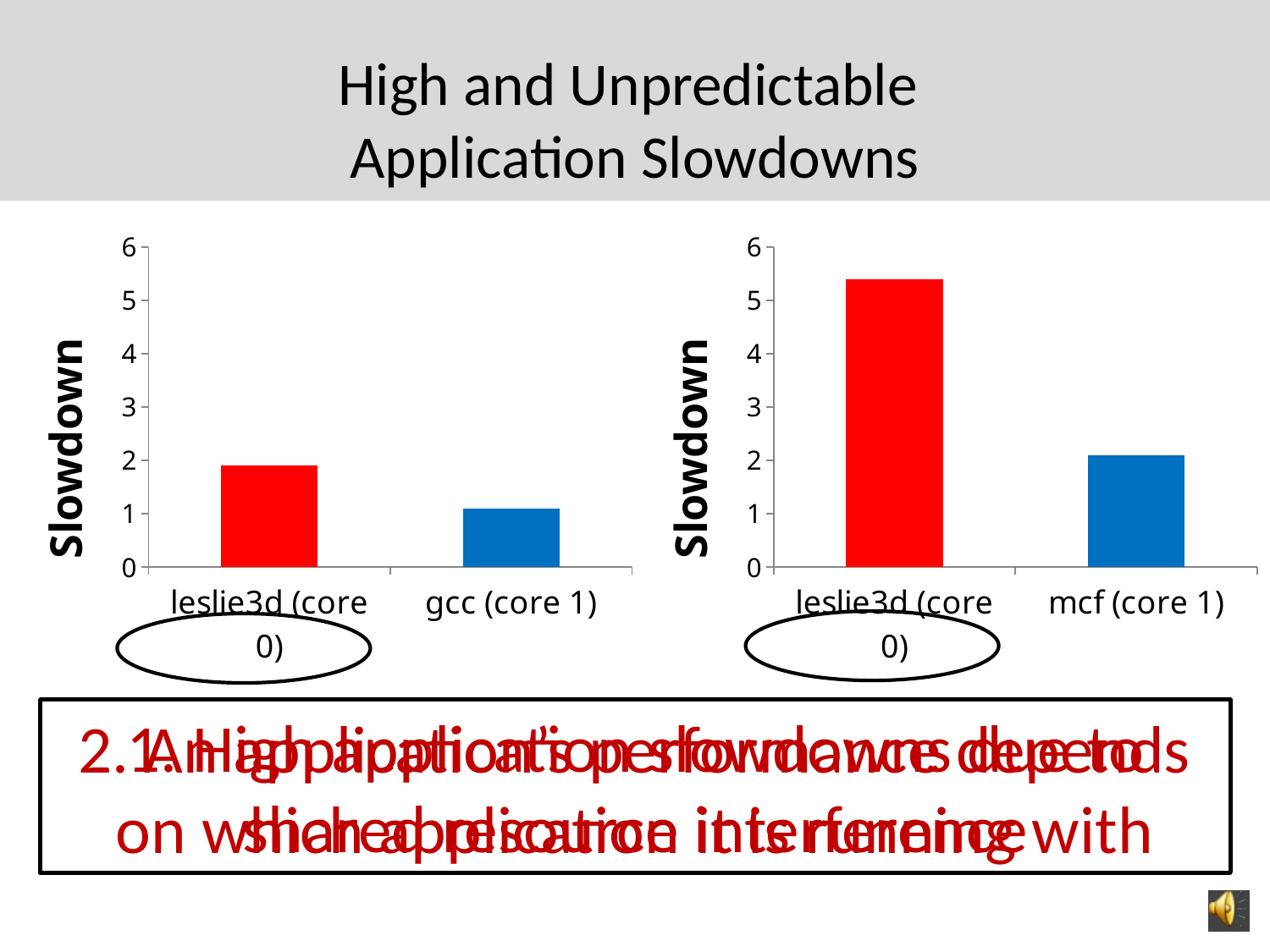
Is the slowdown for leslie3d (core 0) larger in the left chart or in the right chart? right chart What is the label on the y axis of the right chart? Slowdown In the right chart, is the slowdown for mcf (core 1) greater or less than 3? less How many categories does the right chart show? 2 In the right chart, is the slowdown for leslie3d (core 0) greater or less than 5? greater In the right chart, which category has the highest slowdown? leslie3d (core 0) How many categories does the left chart show? 2 In the left chart, which category has the higher slowdown? leslie3d (core 0) What kind of chart is the left chart on the slide? bar chart In the right chart, which category has the lowest slowdown? mcf (core 1) In the left chart, which category has the lower slowdown? gcc (core 1)